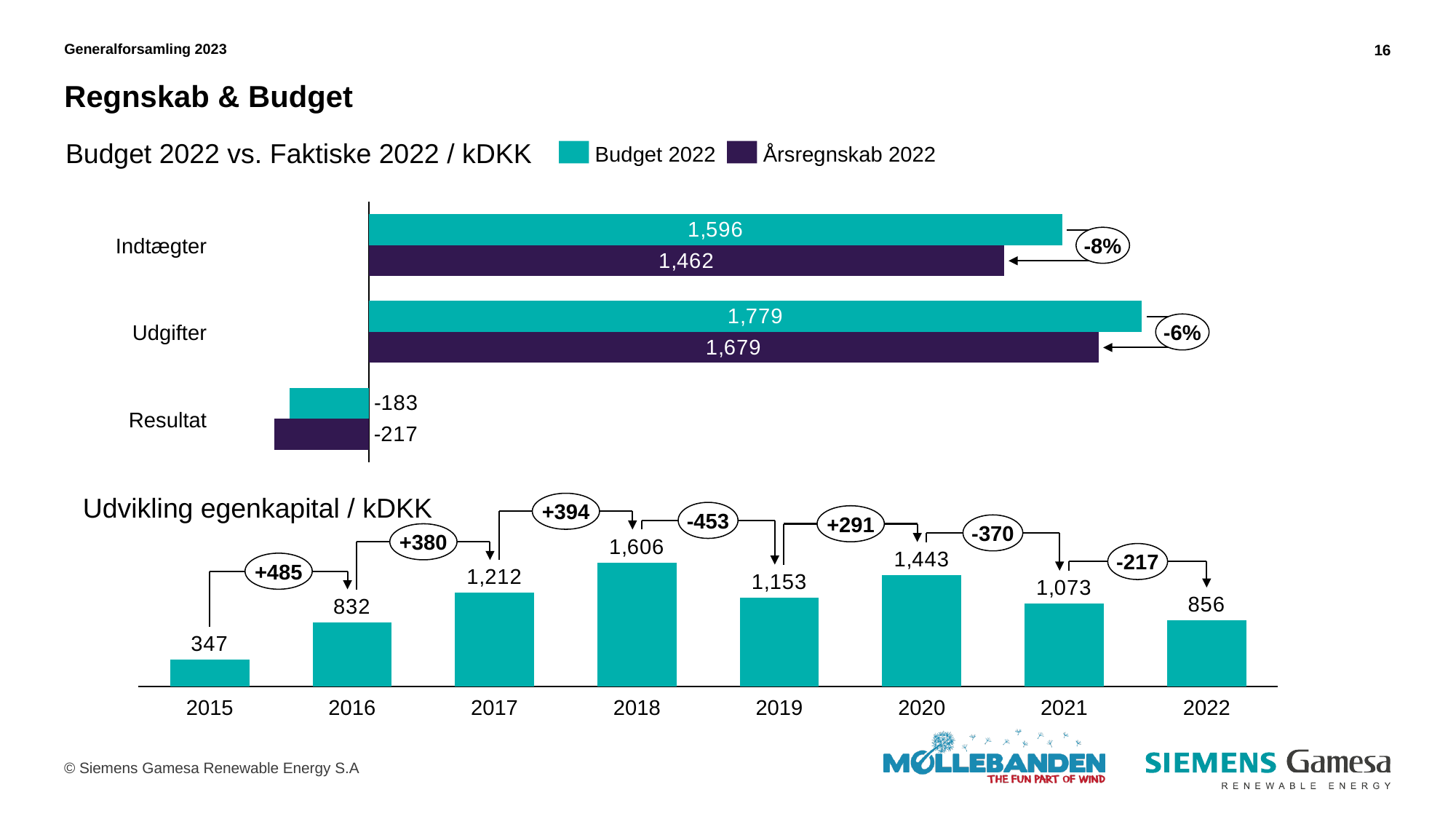
What kind of chart is the 'Udvikling egenkapital / kDKK' chart? Bar chart In the 'Udvikling egenkapital / kDKK' chart, how many years are shown? 8 In the 'Udvikling egenkapital / kDKK' chart, what is the difference between the values for 2020 and 2021? 370 In the 'Udvikling egenkapital / kDKK' chart, which year has the highest value? 2018 In the 'Budget 2022 vs. Faktiske 2022 / kDKK' chart, what is the Årsregnskab 2022 value for Udgifter? 1,679 In the 'Udvikling egenkapital / kDKK' chart, which year has the lowest value? 2015 In the 'Budget 2022 vs. Faktiske 2022 / kDKK' chart, what is the Budget 2022 value for Indtægter? 1,596 In the 'Budget 2022 vs. Faktiske 2022 / kDKK' chart, which is larger for Udgifter: Budget 2022 or Årsregnskab 2022? Budget 2022 In the 'Budget 2022 vs. Faktiske 2022 / kDKK' chart, what is the Årsregnskab 2022 value for Resultat? -217 In the 'Budget 2022 vs. Faktiske 2022 / kDKK' chart, how many series does the legend list? 2 In the 'Udvikling egenkapital / kDKK' chart, what is the value for 2018? 1,606 In the 'Budget 2022 vs. Faktiske 2022 / kDKK' chart, what is the difference between the Budget 2022 and Årsregnskab 2022 values for Indtægter? 134